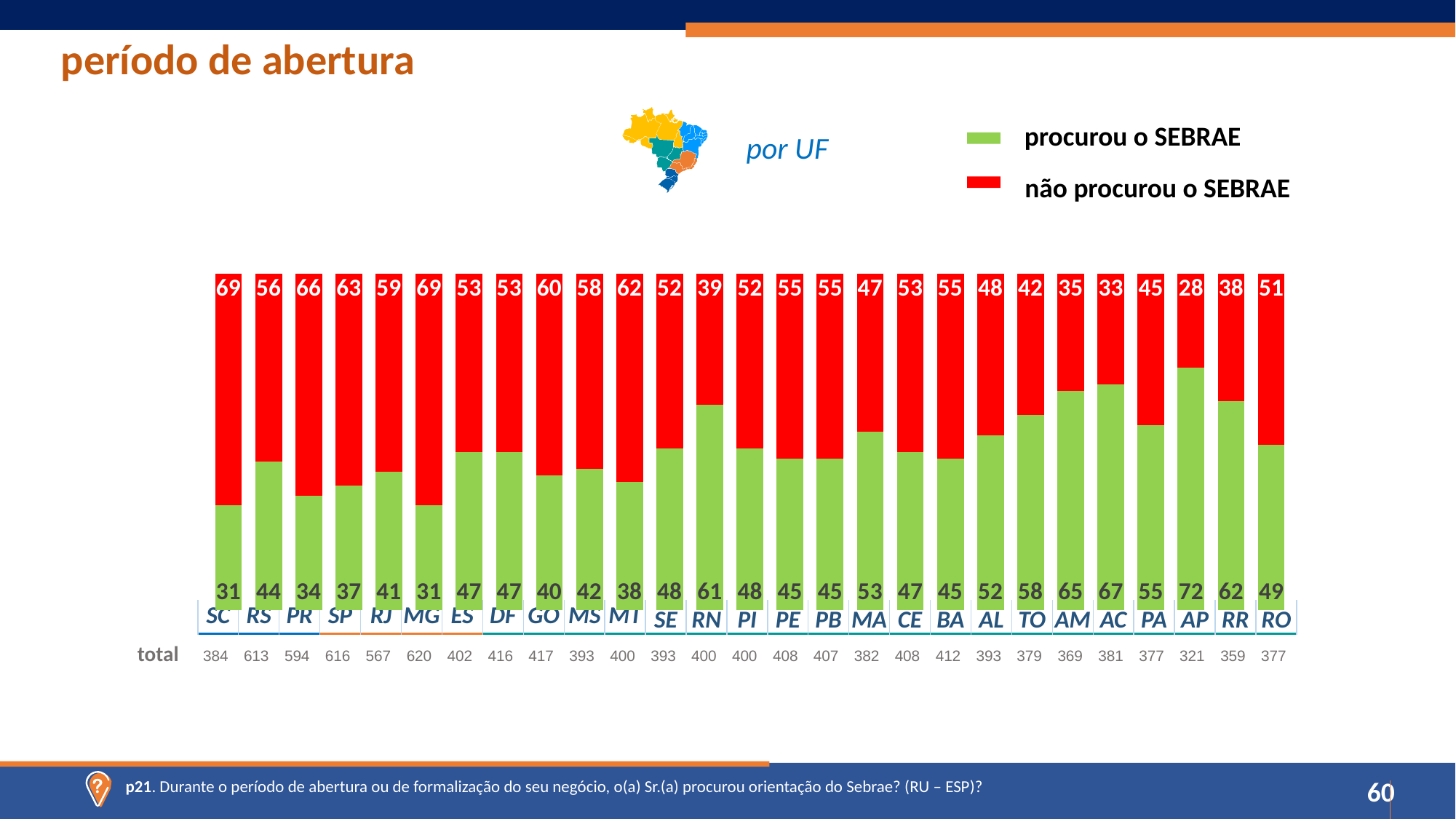
How many UFs are shown on the x axis of the chart? 27 What kind of chart is shown on the slide? stacked bar chart Which UF has the lowest value for não procurou o SEBRAE? AP What is the value for procurou o SEBRAE in RS? 44 Which is larger, the procurou o SEBRAE value for AC or for AM? AC Which colour represents não procurou o SEBRAE in the chart? red What is the difference between the não procurou o SEBRAE values for SC and AP? 41 How many series does the legend list? 2 What percentage of respondents in AP procurou o SEBRAE? 72 What is the value for não procurou o SEBRAE in RN? 39 What is the total number of respondents (total row) for MG? 620 Which UF has the highest value for procurou o SEBRAE? AP